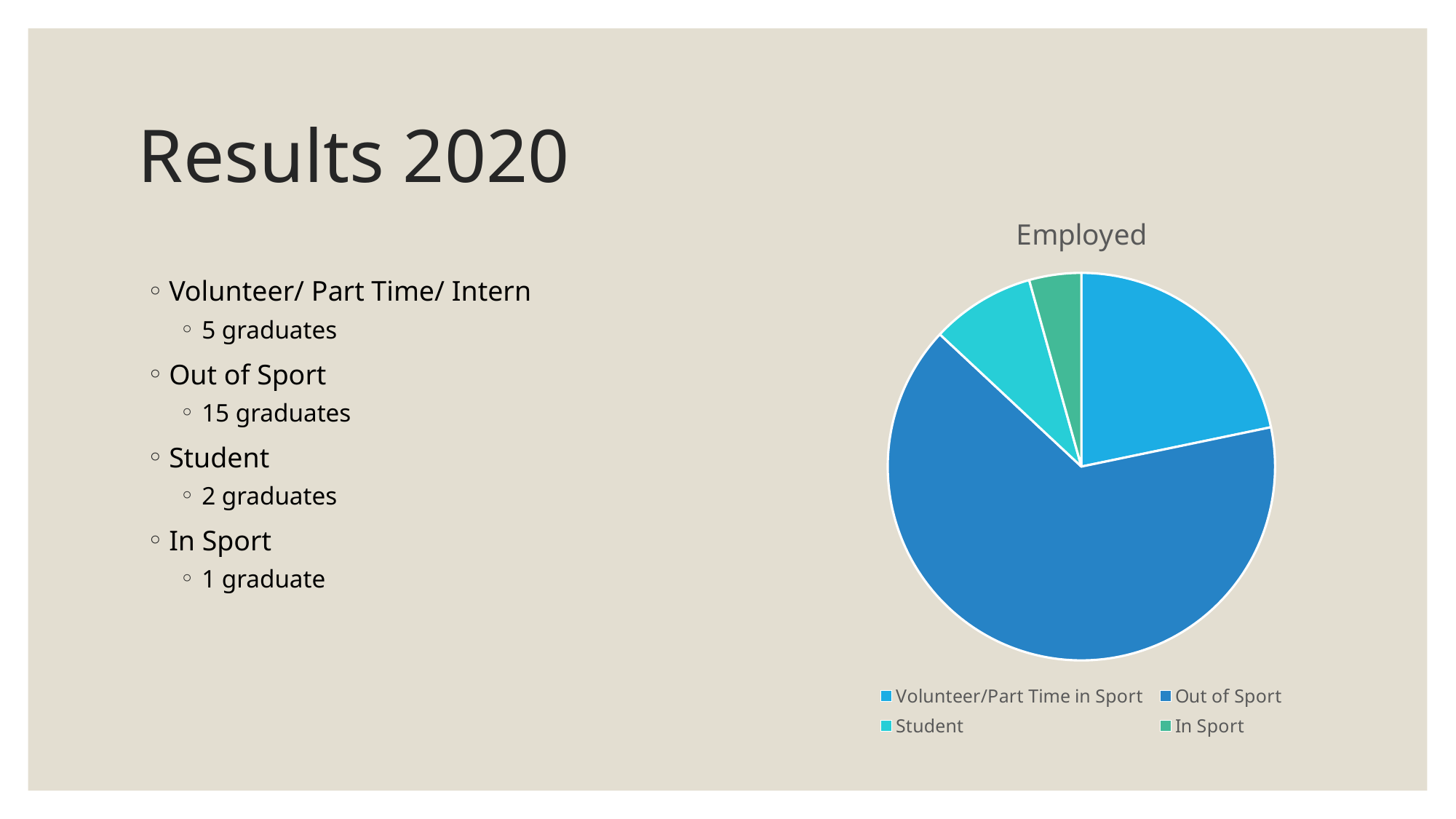
How many graduates are in the Student category? 2 graduates Which slice is larger, Student or Volunteer/Part Time in Sport? Volunteer/Part Time in Sport How many slices does the pie chart have? 4 How many entries does the chart legend list? 4 How many graduates are in the In Sport category? 1 graduate How many more graduates are Out of Sport than Student? 13 Which category has the smallest slice of the pie chart? In Sport Which category has the largest slice of the pie chart? Out of Sport What is the title of the chart? Employed What type of chart is shown on the slide? pie chart Which legend entry is shown in green? In Sport How many graduates are in the Out of Sport category? 15 graduates